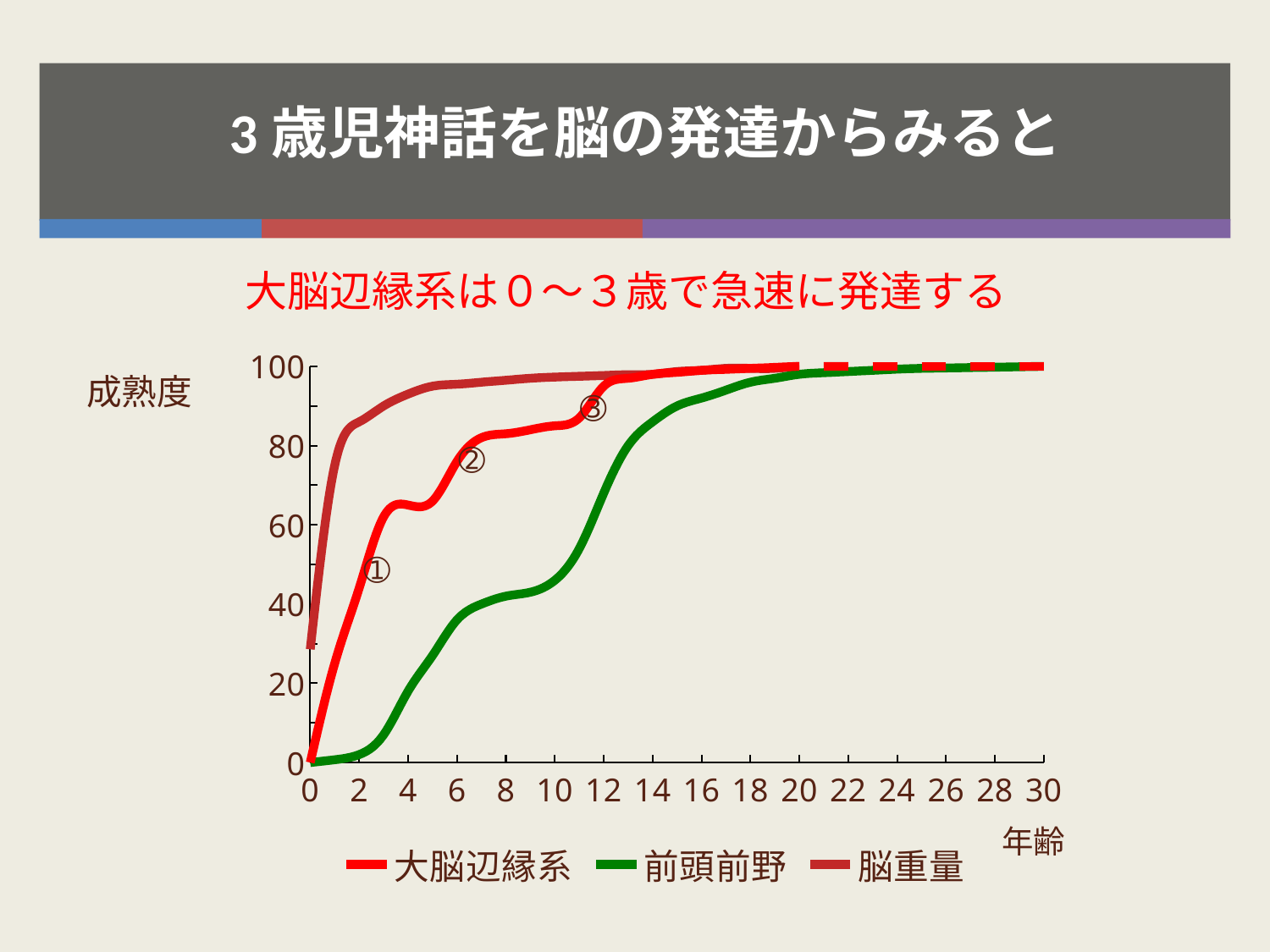
What are the three series named in the legend? 大脳辺縁系, 前頭前野, 脳重量 At age 2, which is higher, 脳重量 or 大脳辺縁系? 脳重量 At age 2, is the value for 脳重量 greater or less than 80? greater At age 12, is the value for 大脳辺縁系 greater or less than 80? greater Do the values for 前頭前野 rise or fall as age increases along the x axis? rise What are the labels of the vertical and horizontal axes? 成熟度 (vertical), 年齢 (horizontal) At age 12, is the value for 前頭前野 greater or less than 60? greater What kind of chart is shown on the slide? line chart How many series does the legend list? 3 Which series has the lowest value at age 4? 前頭前野 At age 6, which is higher, 大脳辺縁系 or 前頭前野? 大脳辺縁系